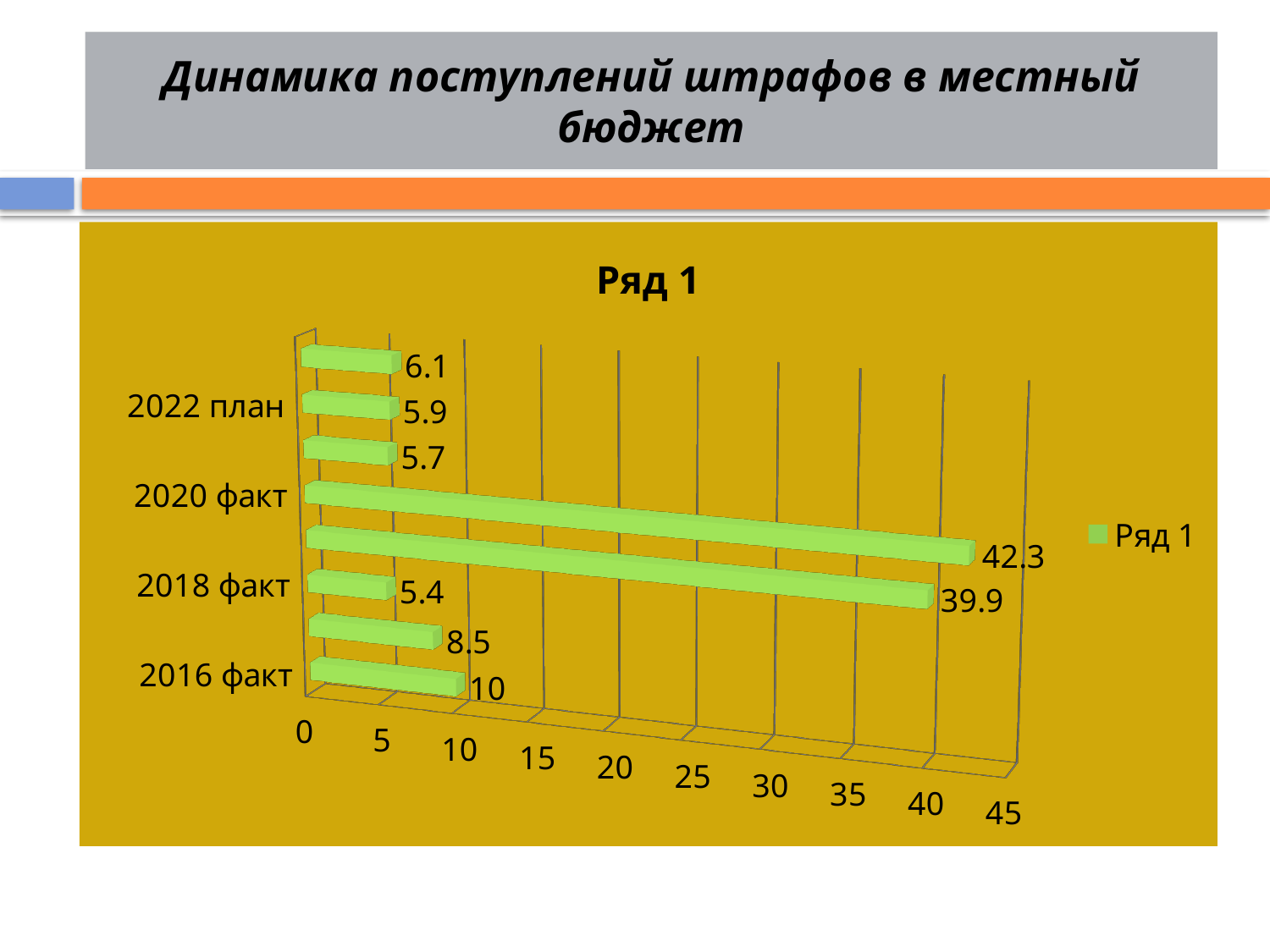
How many series does the legend list? 1 What is the value for 2018 факт? 5.4 What is the value for 2022 план? 5.9 Is the value for 2020 факт greater or less than 40? greater What is the difference between the values for 2020 факт and 2016 факт? 32.3 What is the value for 2016 факт? 10 What kind of chart is shown on the slide? bar chart How many bars are plotted in the chart? 8 Which labelled category has the lowest value? 2018 факт Which is larger, the value for 2016 факт or the value for 2022 план? 2016 факт Which labelled category has the highest value? 2020 факт What is the value for 2020 факт? 42.3